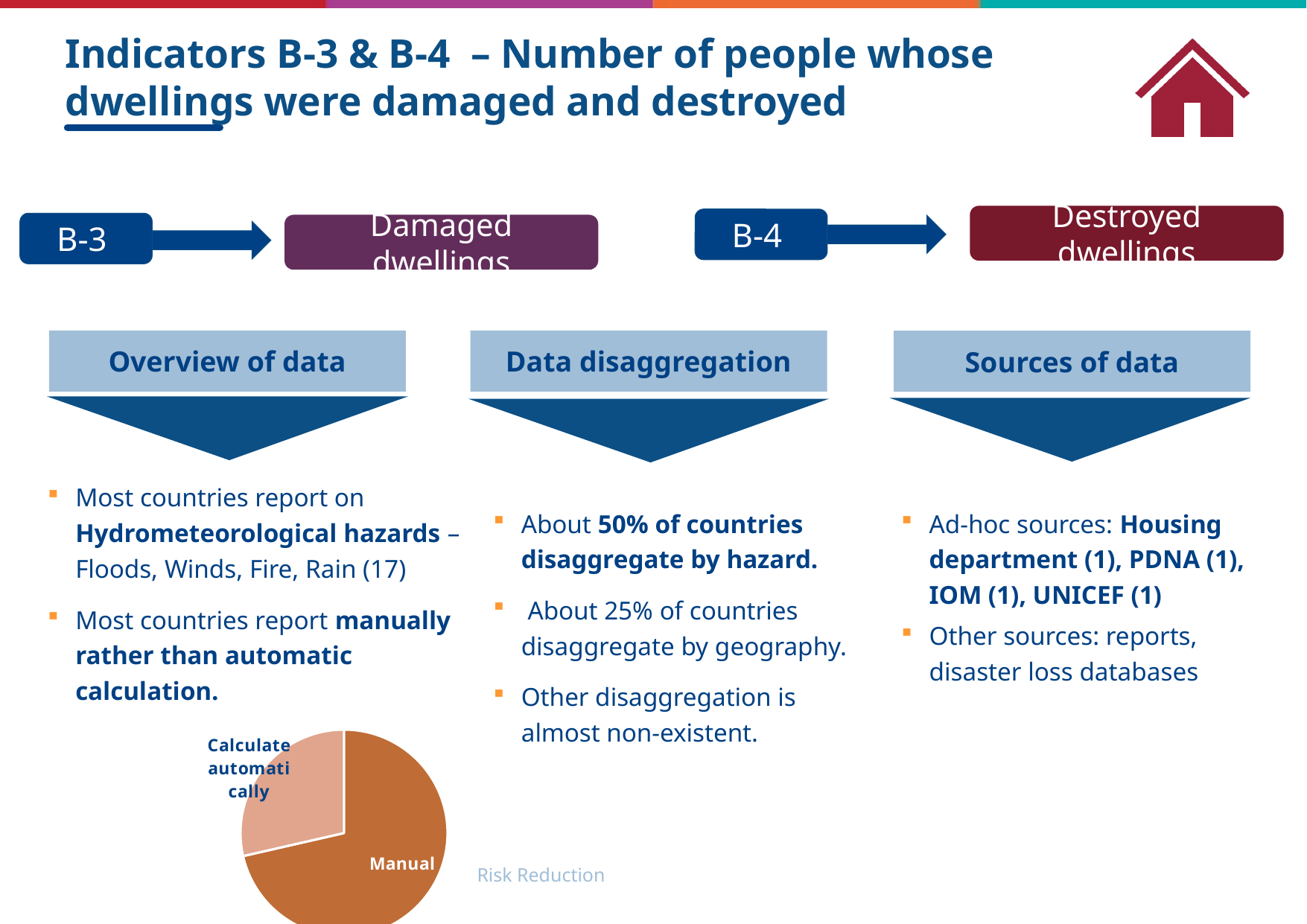
Which slice of the pie chart is the smallest? Calculate automatically What colour is the Manual slice in the pie chart? dark orange What are the labels of the two slices in the pie chart? Manual and Calculate automatically How many slices does the pie chart have? 2 Which slice of the pie chart is the largest? Manual In the pie chart, which is larger: the Manual slice or the Calculate automatically slice? Manual What kind of chart is shown at the bottom left of the slide? pie chart